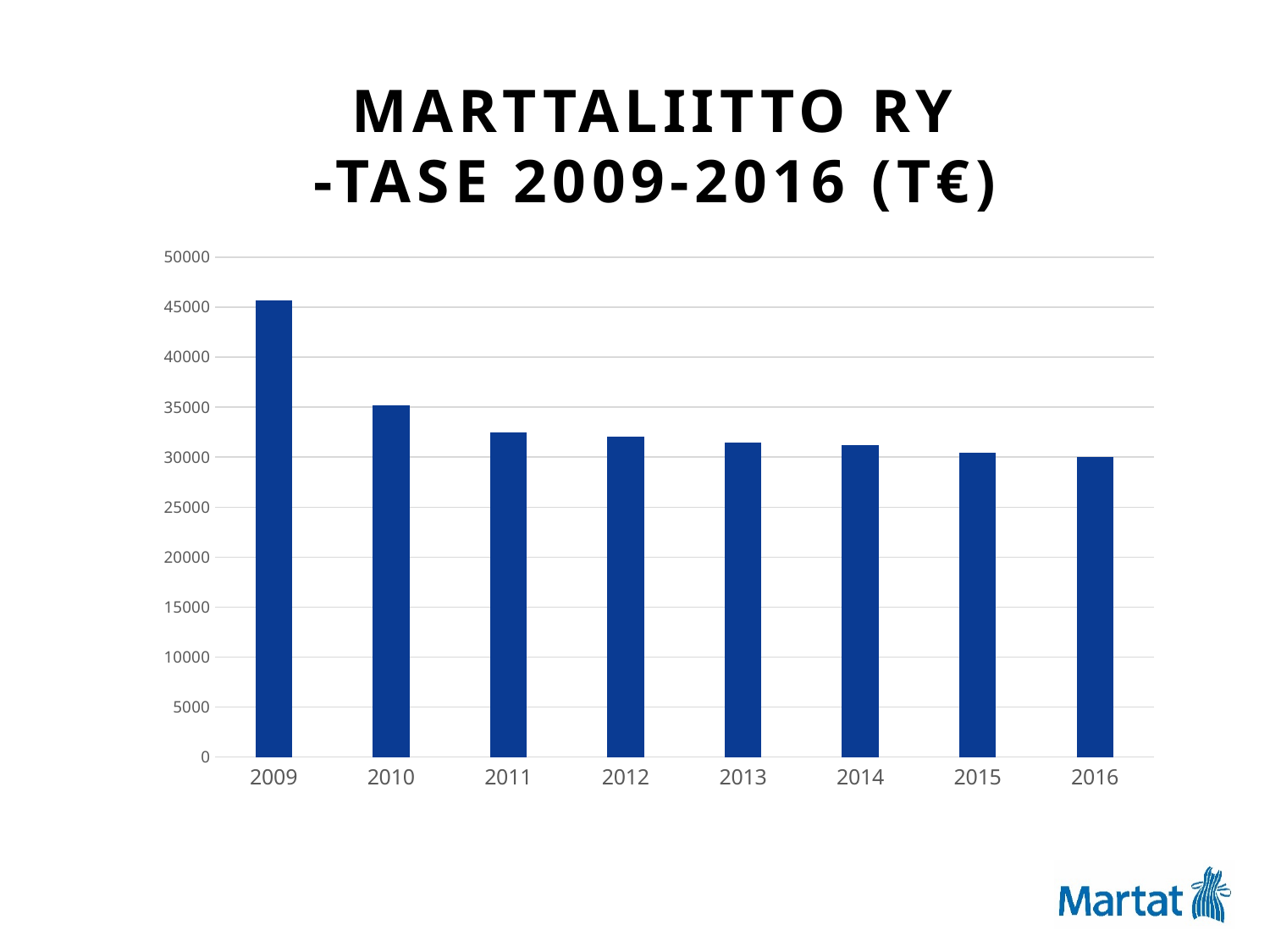
Is the value for 2013 greater or less than 35000? less Is the value for 2015 greater or less than 25000? greater Which is larger, the value for 2009 or the value for 2010? 2009 How many years are shown on the x axis of the chart? 8 Which is larger, the value for 2011 or the value for 2014? 2011 Which year has the highest value in the chart? 2009 Do the values rise or fall from 2009 to 2016? fall Is the value for 2011 greater or less than 30000? greater What kind of chart is shown on the slide? Bar chart What is the title of the chart on the slide? MARTTALIITTO RY -TASE 2009-2016 (T€)